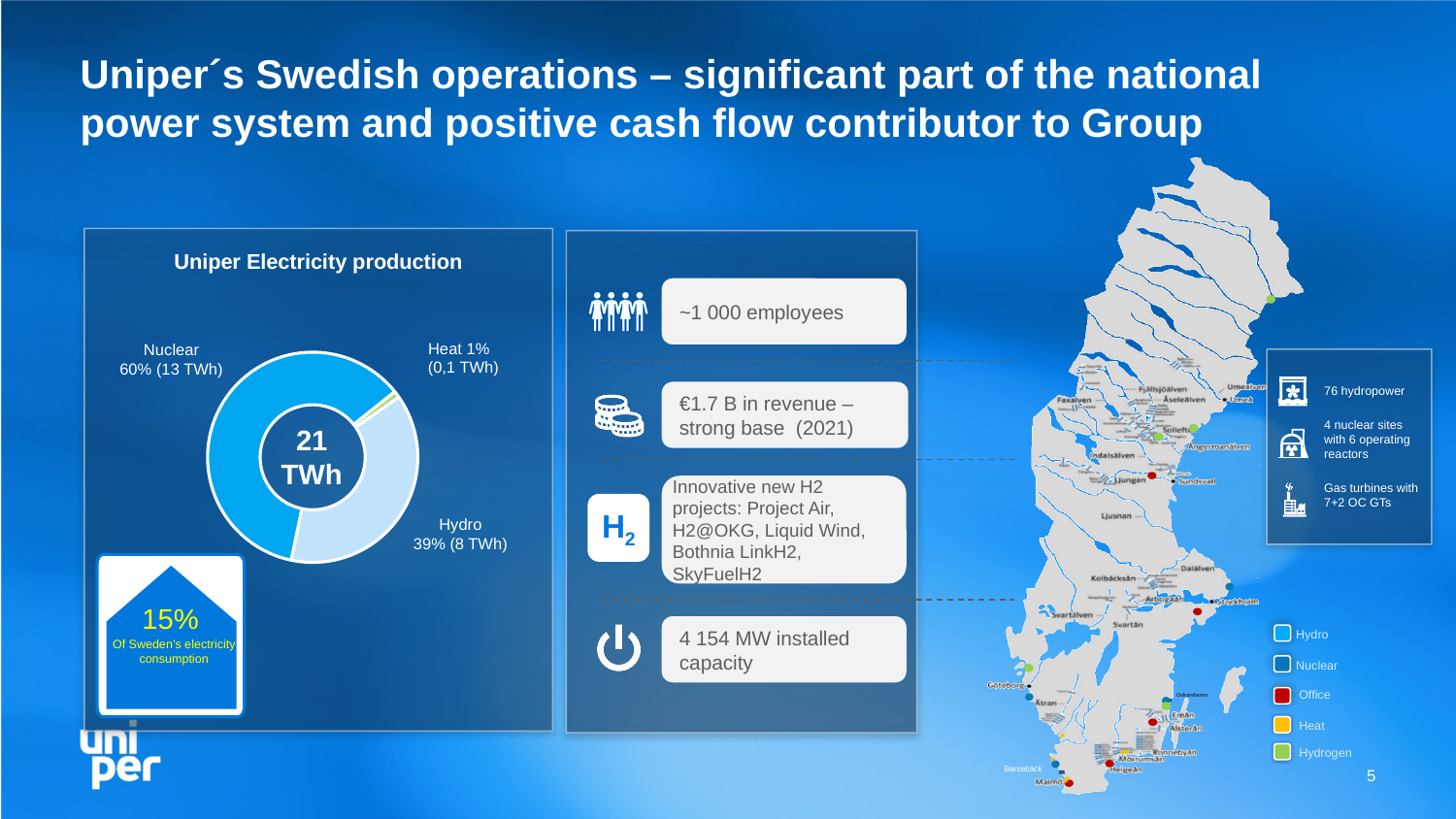
What kind of chart is used to show Uniper Electricity production? Donut (pie) chart What is the difference in TWh between Nuclear and Hydro in the Uniper Electricity production chart? 5 TWh What total value is shown in the centre of the Uniper Electricity production chart? 21 TWh How many categories are shown in the Uniper Electricity production chart? 3 What share of Uniper Electricity production comes from Hydro? 39% Which source is the smallest slice of the Uniper Electricity production chart? Heat What share of Uniper Electricity production comes from Heat? 1% How many TWh of Uniper Electricity production come from Hydro? 8 TWh How many TWh of Uniper Electricity production come from Heat? 0,1 TWh Which source is the largest slice of the Uniper Electricity production chart? Nuclear What share of Uniper Electricity production comes from Nuclear? 60% How many TWh of Uniper Electricity production come from Nuclear? 13 TWh